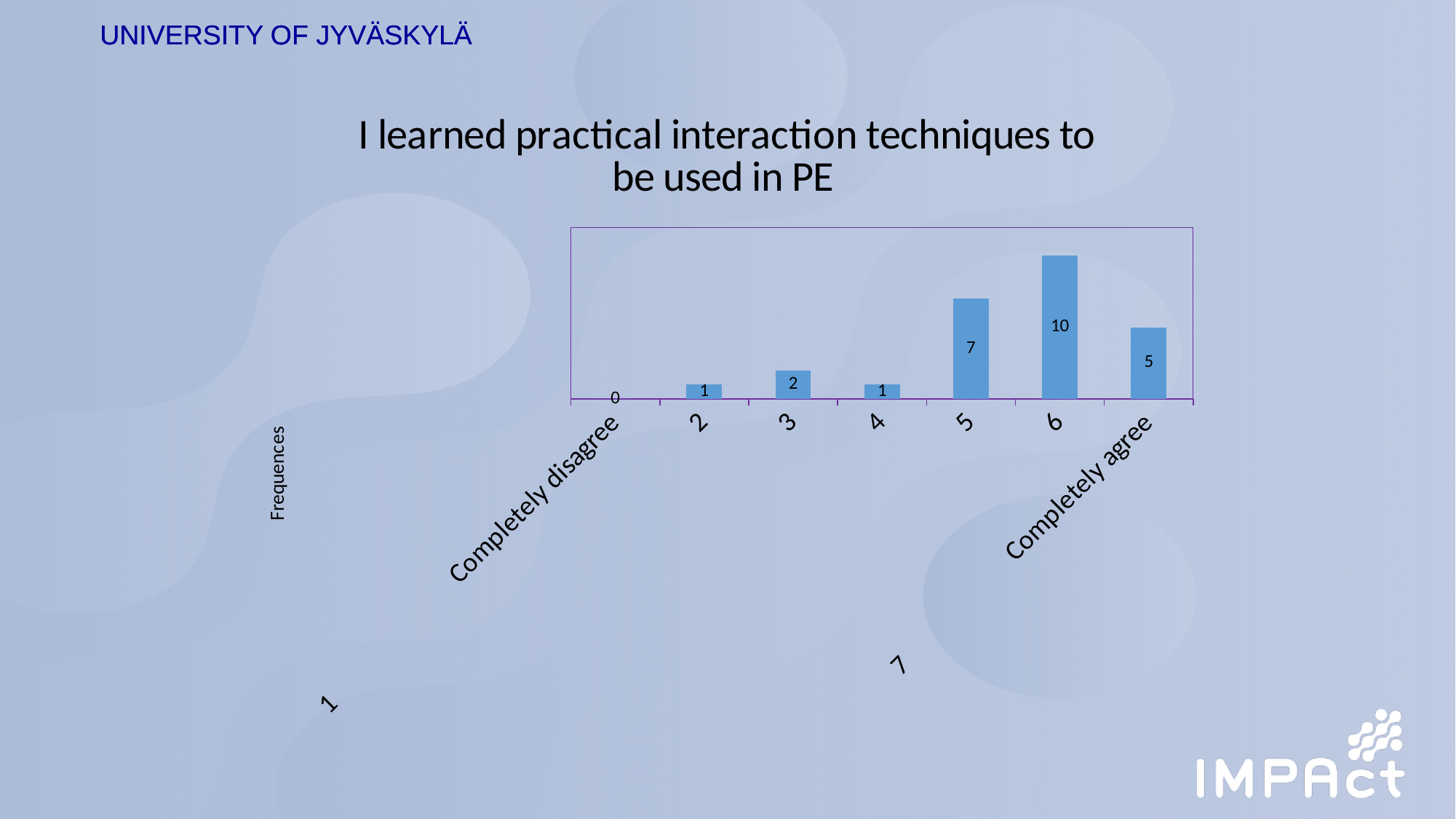
Which has a higher frequency, category 5 or 'Completely agree'? 5 What is the frequency for category 5? 7 What is the frequency for 'Completely disagree'? 0 What is the label of the vertical axis? Frequences What kind of chart is shown on the slide? Bar chart What is the difference between the frequencies for category 6 and category 5? 3 Which category has the highest frequency? 6 How many categories are shown on the x axis? 7 What is the frequency for category 3? 2 Which category has the lowest frequency? Completely disagree What is the frequency for 'Completely agree'? 5 What is the frequency for category 6? 10